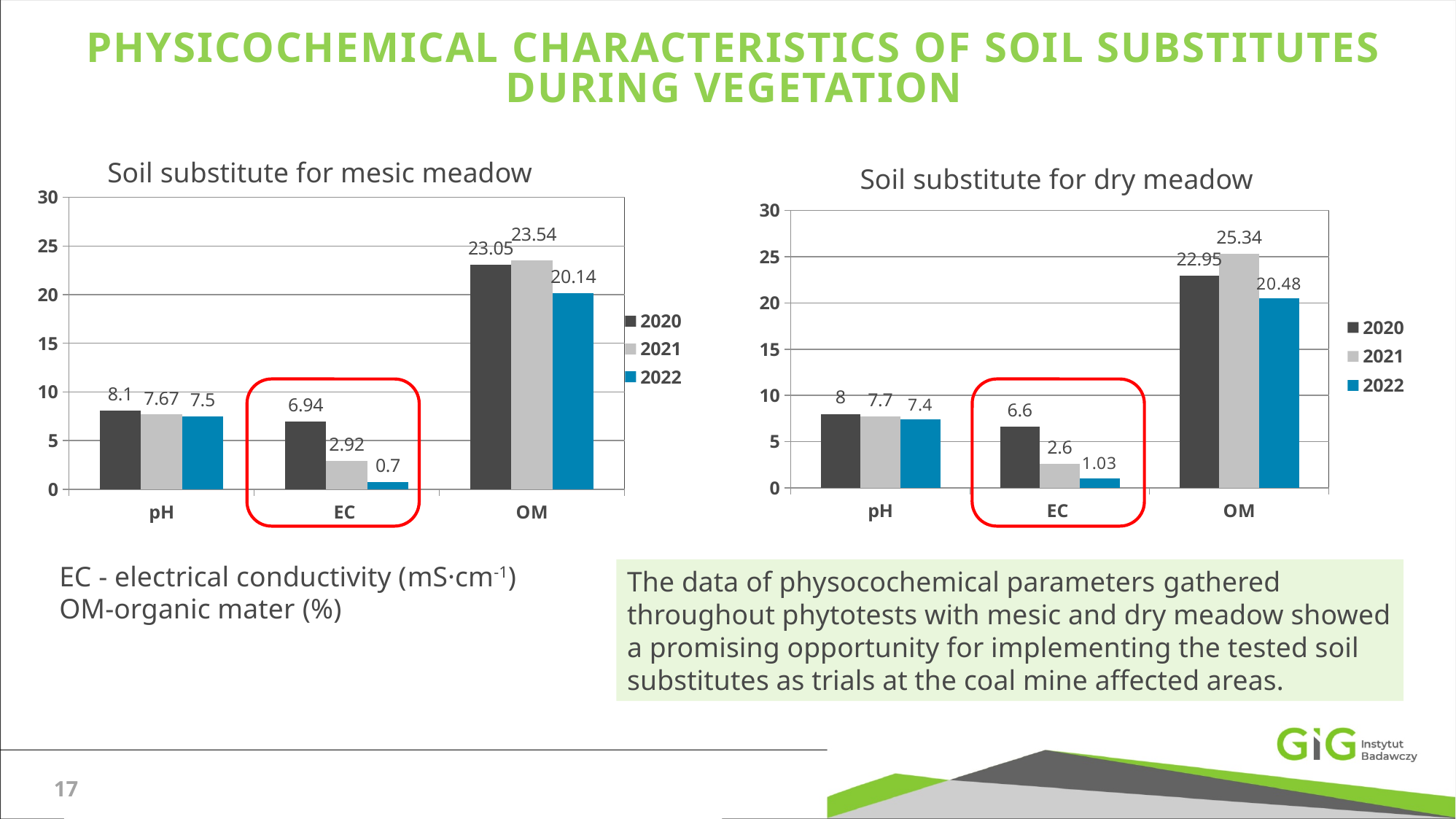
How many series does the legend list in the 'Soil substitute for dry meadow' chart? 3 In the 'Soil substitute for dry meadow' chart, what is the OM value for 2021? 25.34 In the 'Soil substitute for mesic meadow' chart, which year has the highest OM value? 2021 In the 'Soil substitute for mesic meadow' chart, what is the EC value for 2020? 6.94 In the 'Soil substitute for dry meadow' chart, which year has the lowest EC value? 2022 In the 'Soil substitute for mesic meadow' chart, what is the difference between the EC values for 2020 and 2021? 4.02 In the 'Soil substitute for mesic meadow' chart, what is the pH value for 2022? 7.5 In the 'Soil substitute for mesic meadow' chart, how does the EC value change from 2020 to 2022? It falls In the 'Soil substitute for dry meadow' chart, what is the difference between the OM values for 2021 and 2022? 4.86 In the 'Soil substitute for dry meadow' chart, what is the EC value for 2022? 1.03 What kind of chart is the 'Soil substitute for mesic meadow' chart? Bar chart In the 'Soil substitute for dry meadow' chart, which is larger: the pH value for 2020 or the EC value for 2020? pH value for 2020